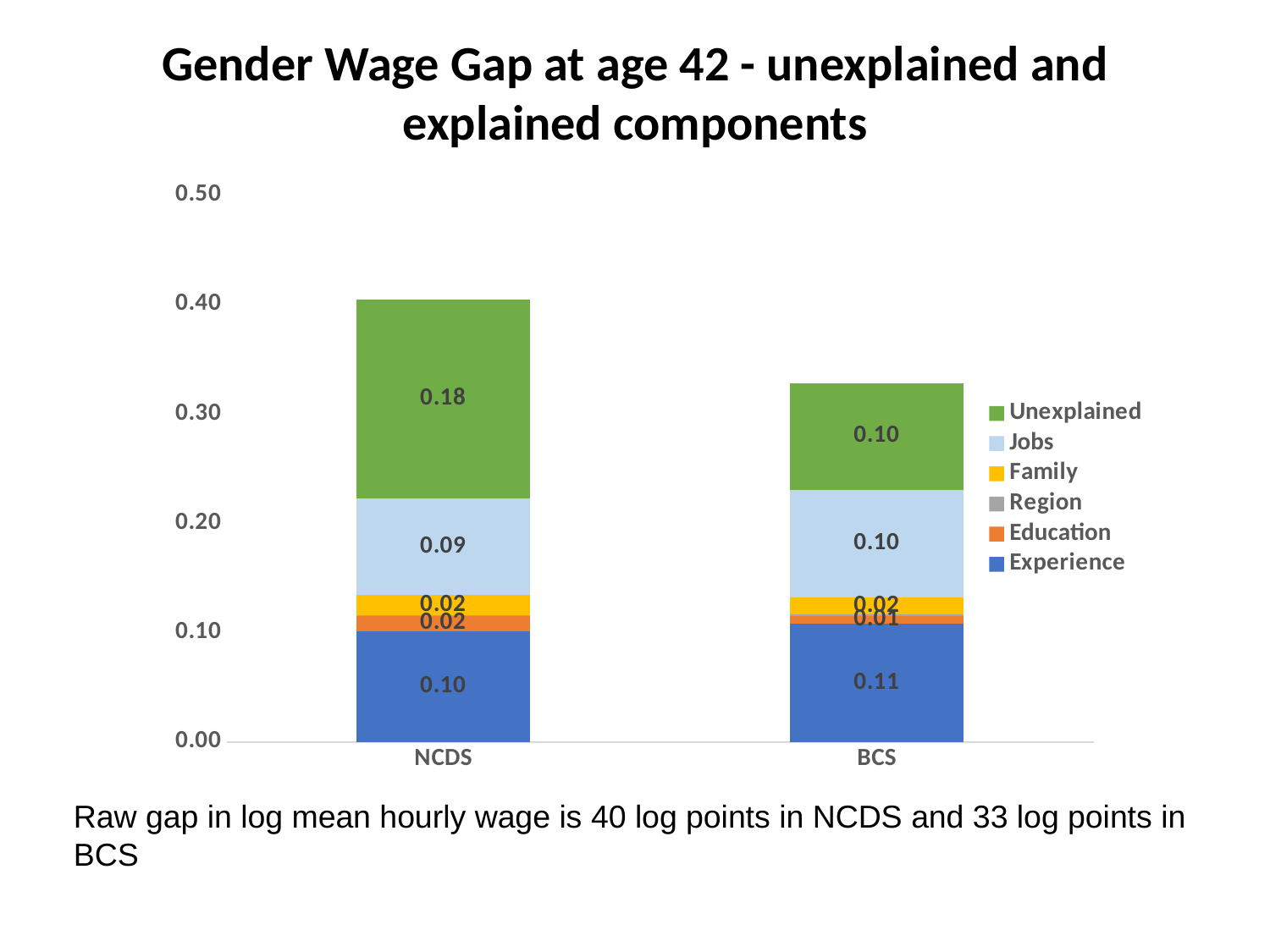
What is the value of the Experience component for BCS? 0.11 What kind of chart is shown on the slide? Stacked bar chart Which is larger, the Jobs component for NCDS or for BCS? BCS How many series does the legend list? 6 Is the total height of the BCS bar greater or less than 0.40? less What is the difference between the Unexplained component for NCDS and for BCS? 0.08 Is the total height of the NCDS bar greater or less than 0.30? greater What is the value of the Unexplained component for NCDS? 0.18 Which component is the largest in the NCDS bar? Unexplained What is the value of the Education component for NCDS? 0.02 What is the value of the Jobs component for BCS? 0.10 How many categories are shown on the x axis? 2